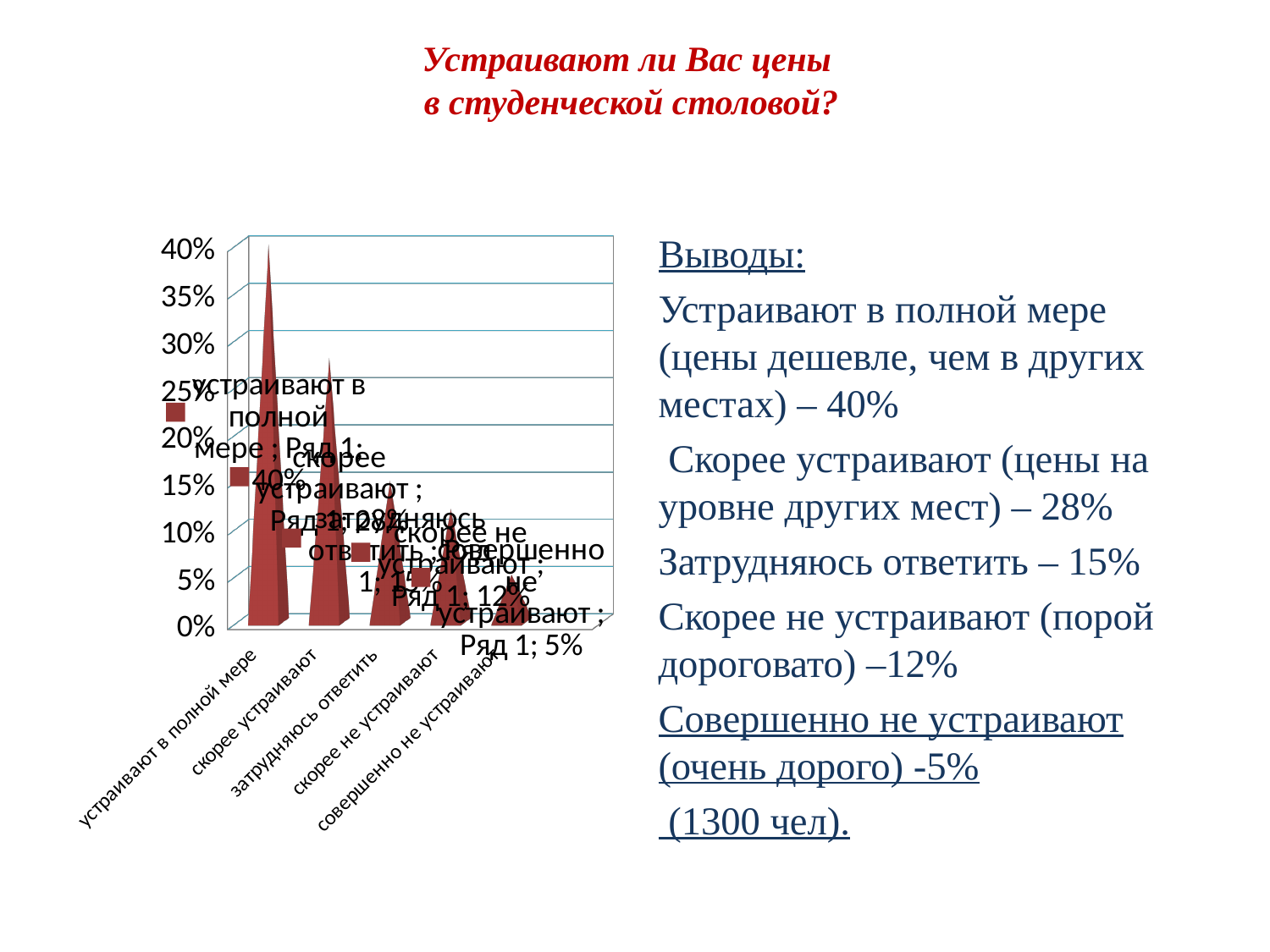
Which category has the lowest value in the chart? совершенно не устраивают What is the difference between the values for "устраивают в полной мере" and "скорее устраивают"? 12% What value does the chart show for "скорее устраивают"? 28% What value does the chart show for "затрудняюсь ответить"? 15% Which category has the highest value in the chart? устраивают в полной мере How many categories are shown on the x axis of the chart? 5 Do the values rise or fall from left to right along the x axis? fall What value does the chart show for "устраивают в полной мере"? 40% What value does the chart show for "совершенно не устраивают"? 5% What value does the chart show for "скорее не устраивают"? 12% What kind of chart is shown on the slide? bar chart Which is larger: the value for "затрудняюсь ответить" or the value for "скорее не устраивают"? затрудняюсь ответить